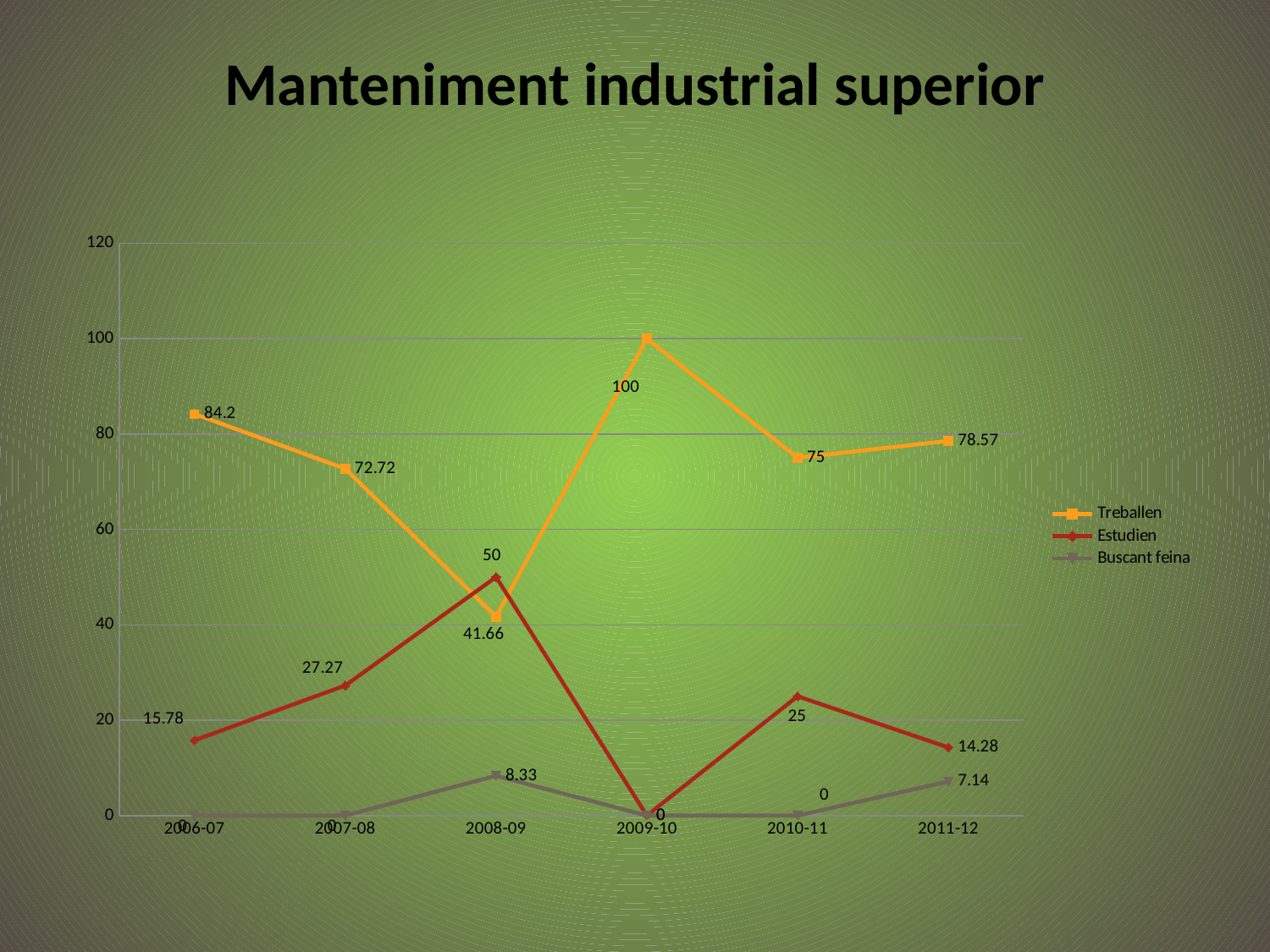
What is the value for Estudien in 2007-08? 27.27 What is the value for Treballen in 2009-10? 100 What is the title of the chart? Manteniment industrial superior How many academic years are shown on the x axis? 6 In which year is the Treballen value lowest? 2008-09 Which is larger in 2010-11, Treballen or Estudien? Treballen In which year is the Estudien value highest? 2008-09 What is the value for Buscant feina in 2011-12? 7.14 What is the difference between the Treballen values in 2006-07 and 2007-08? 11.48 What type of chart is shown on the slide? line chart How many series does the legend list? 3 Does the Estudien series rise or fall from 2006-07 to 2008-09? rise